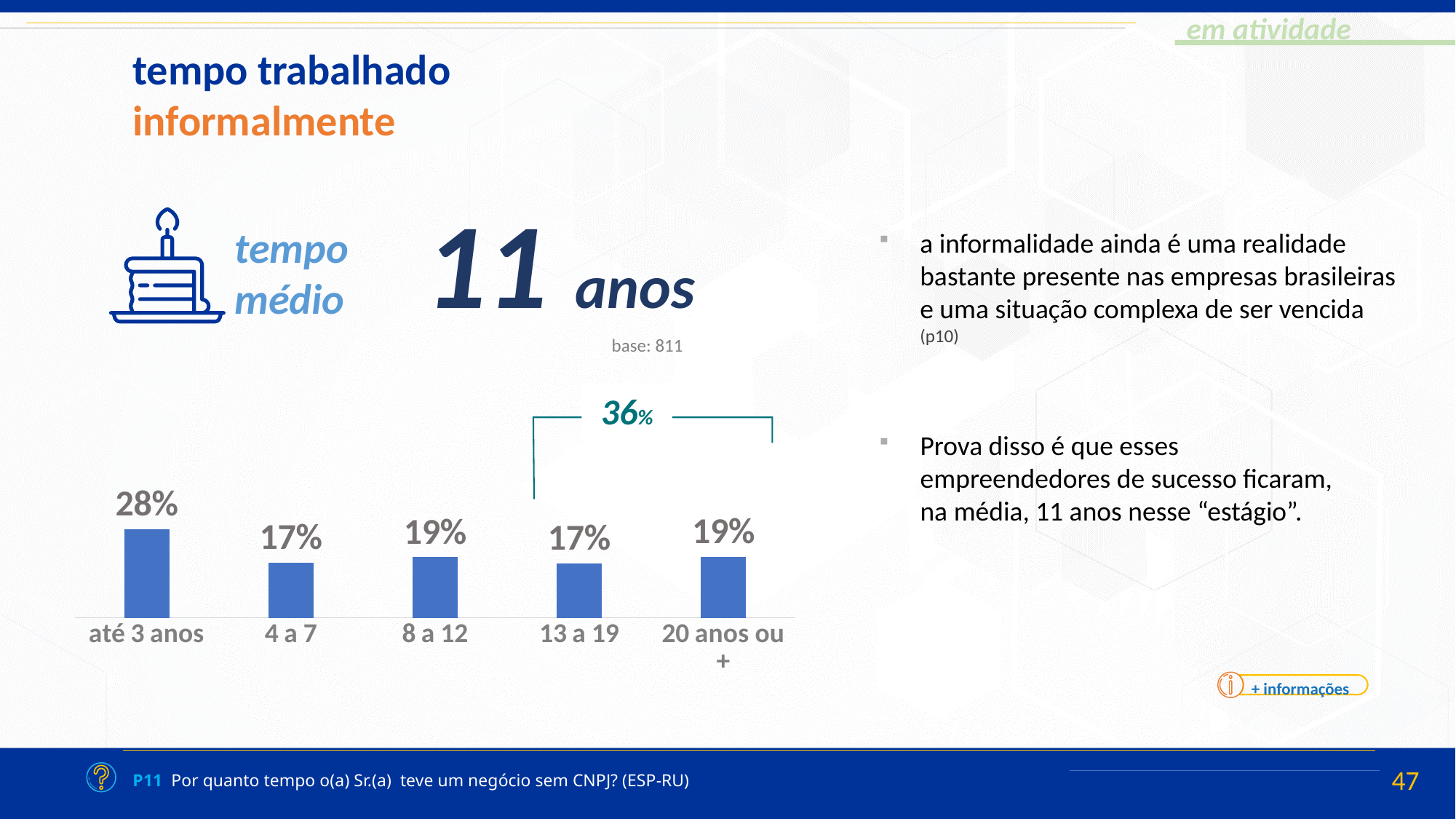
What is the value for the '8 a 12' category? 19% Which is larger, the value for 'até 3 anos' or the value for '8 a 12'? até 3 anos What is the value for the 'até 3 anos' category? 28% What kind of chart is shown on the slide? bar chart What combined percentage is shown by the bracket over the '13 a 19' and '20 anos ou +' bars? 36% What is the difference between the values for 'até 3 anos' and '13 a 19'? 11% What is the value for the '4 a 7' category? 17% What is the difference between the values for '8 a 12' and '4 a 7'? 2% How many categories are shown in the bar chart? 5 What is the base (sample size) shown for the chart? 811 What is the value for the '20 anos ou +' category? 19% Which category has the highest value? até 3 anos